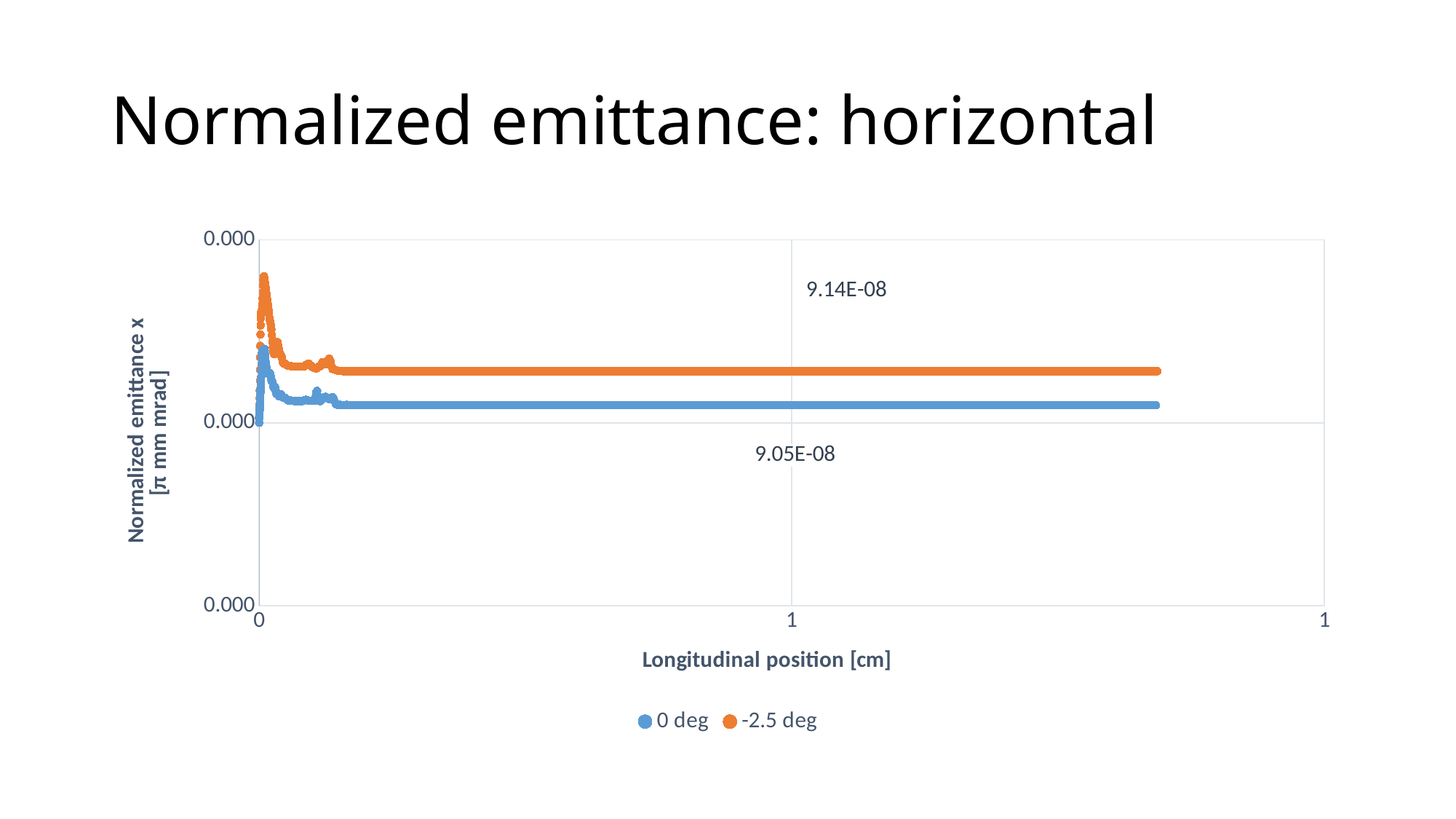
What value is labelled on the chart for the 0 deg series? 9.05E-08 What is the title of the x axis? Longitudinal position [cm] What kind of chart is shown on the slide? scatter chart Which series reaches the higher peak near the start of the x axis? -2.5 deg After its initial peak, does the 0 deg series rise or fall before levelling off? fall How many series does the legend list? 2 After its initial peak, does the -2.5 deg series rise or fall before levelling off? fall What value is labelled on the chart for the -2.5 deg series? 9.14E-08 Which series sits lower along the flat part of the chart? 0 deg Which series has the higher labelled value, 0 deg or -2.5 deg? -2.5 deg What colour are the markers for the -2.5 deg series? orange